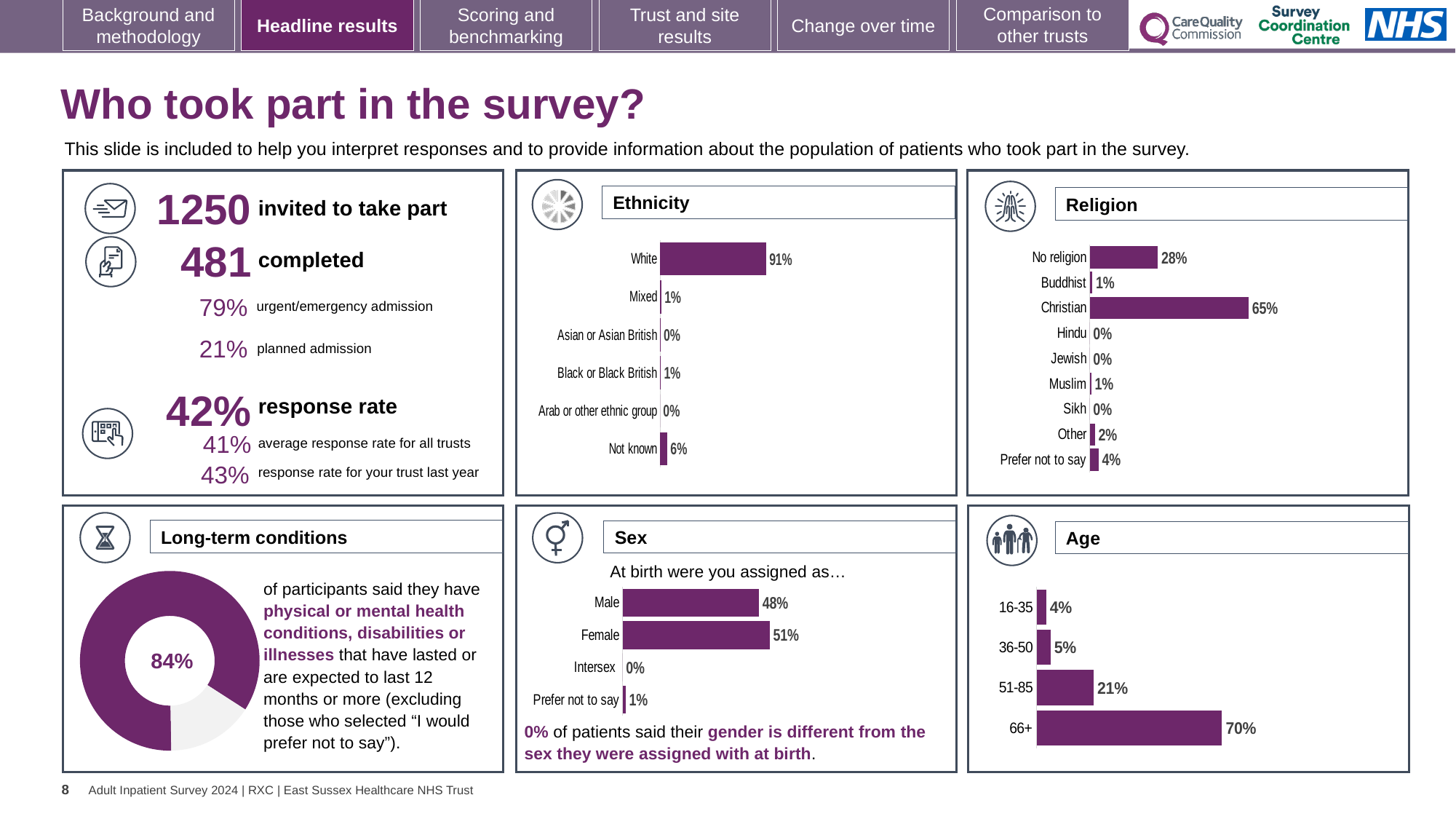
In the Ethnicity chart, what percentage of respondents were White? 91% In the Religion chart, what is the difference between the Christian and No religion values? 37 percentage points In the Sex chart, which is larger, Male or Female? Female In the Religion chart, which category has the highest value? Christian In the Age chart, what is the difference between the 66+ and 16-35 values? 66 percentage points In the Ethnicity chart, what percentage of respondents were recorded as Not known? 6% In the Religion chart, what percentage of respondents said they had no religion? 28% In the Age chart, which age group has the highest value? 66+ In the Religion chart, how many categories are shown? 9 In the Age chart, what percentage of respondents were aged 51-85? 21% In the Sex chart, what percentage of respondents were assigned Male at birth? 48% What kind of chart is used in the Long-term conditions panel? Doughnut chart